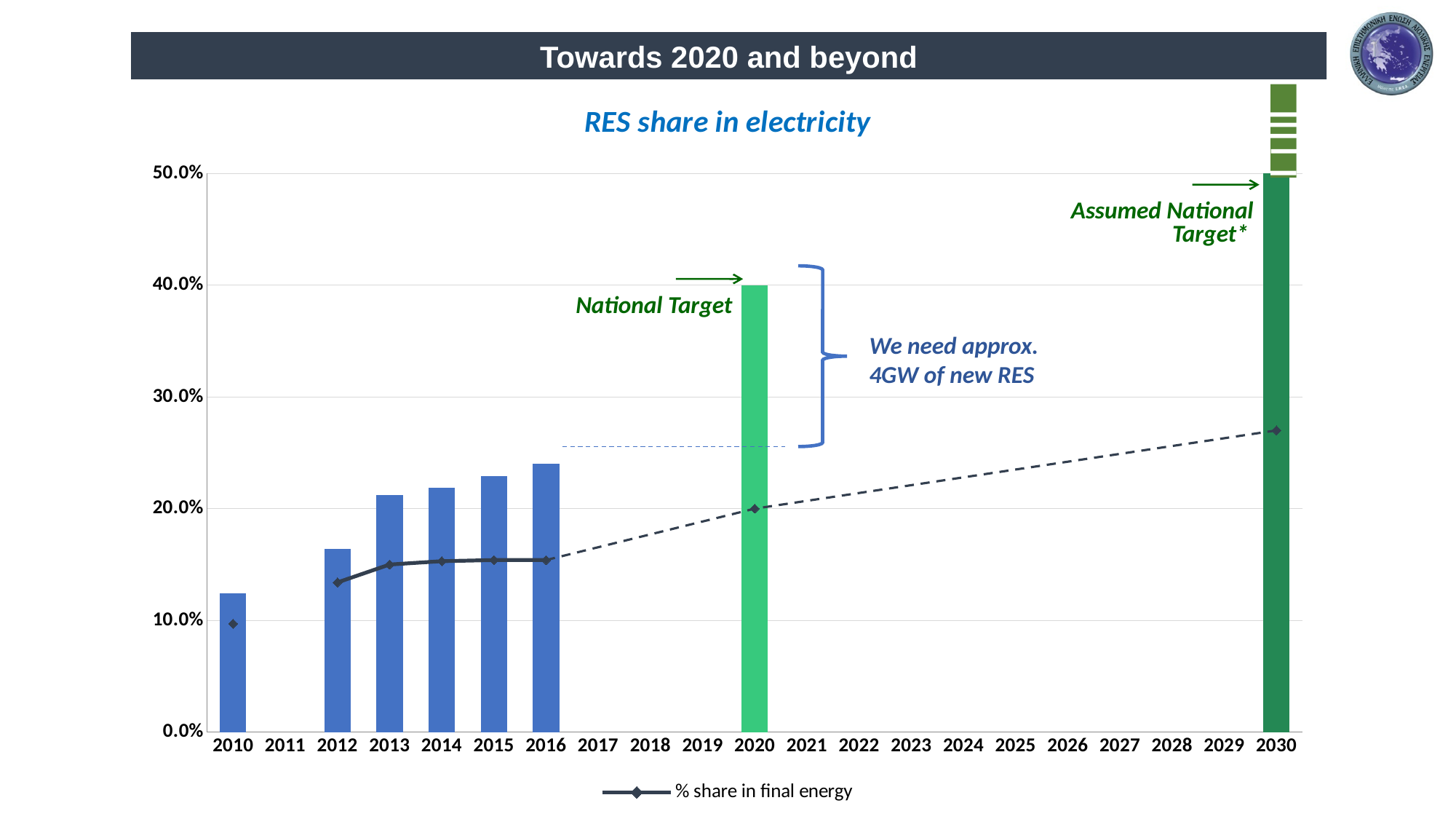
Is the value of the bar for 2016 greater or less than 20.0%? greater Which year has the lowest bar? 2010 What is the value of the bar for 2020 (National Target)? 40.0% What kind of chart is shown on the slide? bar and line chart Which year has the highest bar? 2030 What is the title of the chart? RES share in electricity What is the value of the bar for 2030 (Assumed National Target)? 50.0% What is the difference between the 2030 bar and the 2020 bar? 10.0% Is the value of the bar for 2012 greater or less than 20.0%? less How many series does the legend list? 1 Do the bars rise or fall from 2012 to 2016? rise Which bar is taller, 2013 or 2016? 2016